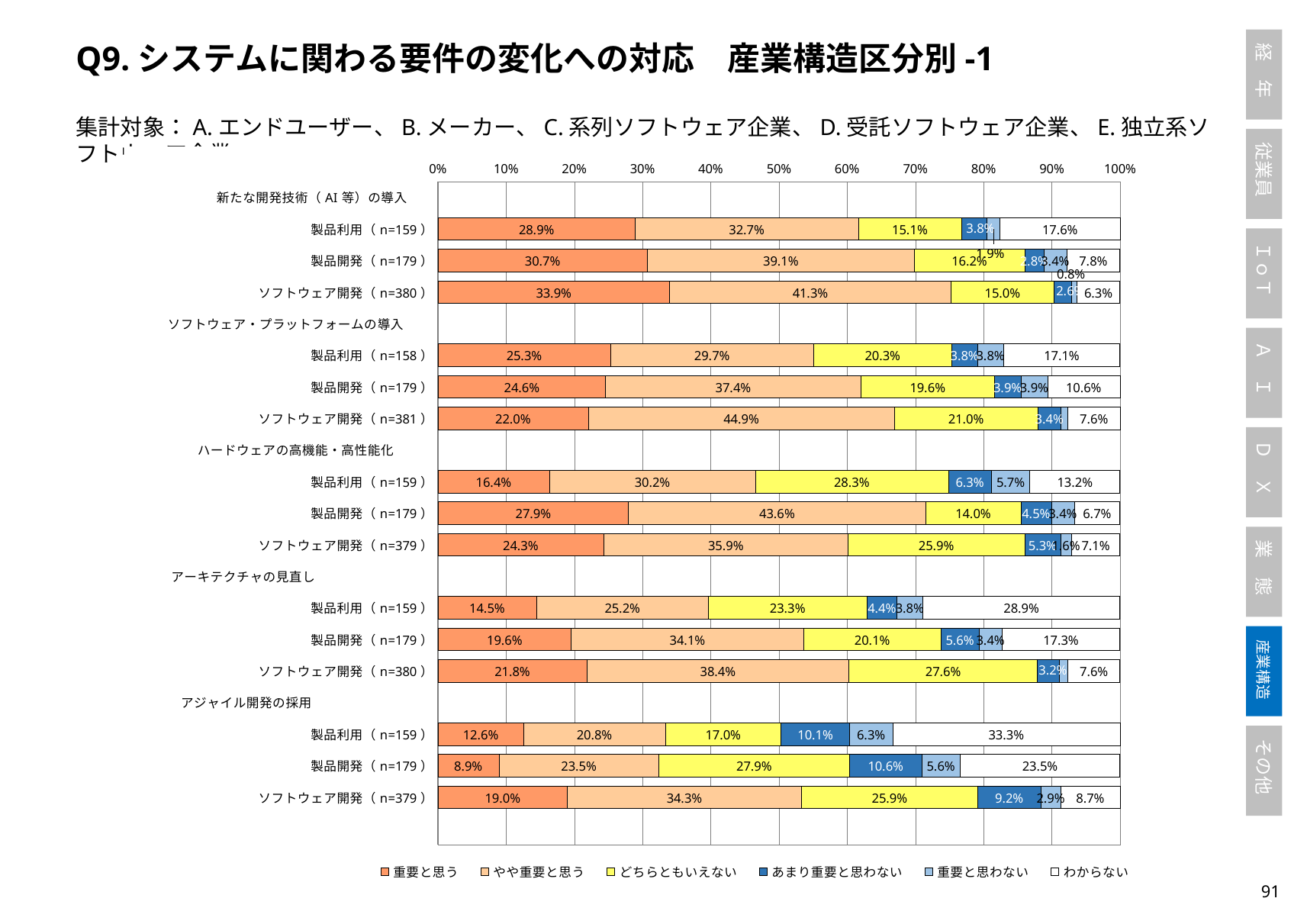
How many series does the legend list? 6 Which bar has the lowest 重要と思う value across the whole chart? 製品開発 (n=179) under アジャイル開発の採用 What is the difference between the わからない values for 製品利用 (n=159) and ソフトウェア開発 (n=380) under アーキテクチャの見直し? 21.3% What is the first legend entry of the chart? 重要と思う What is the あまり重要と思わない value for 製品開発 (n=179) under アジャイル開発の採用? 10.6% What is the やや重要と思う value for ソフトウェア開発 (n=381) under ソフトウェア・プラットフォームの導入? 44.9% How many topic groups (e.g. 新たな開発技術（AI等）の導入) are shown on the chart? 5 Under ハードウェアの高機能・高性能化, which has the larger やや重要と思う value: 製品利用 (n=159) or 製品開発 (n=179)? 製品開発 (n=179) What is the 重要と思う value for ソフトウェア開発 (n=380) under 新たな開発技術（AI等）の導入? 33.9% What kind of chart is shown on the slide? Stacked bar chart What is the わからない value for 製品利用 (n=159) under アジャイル開発の採用? 33.3% Which bar has the highest 重要と思う value across the whole chart? ソフトウェア開発 (n=380) under 新たな開発技術（AI等）の導入